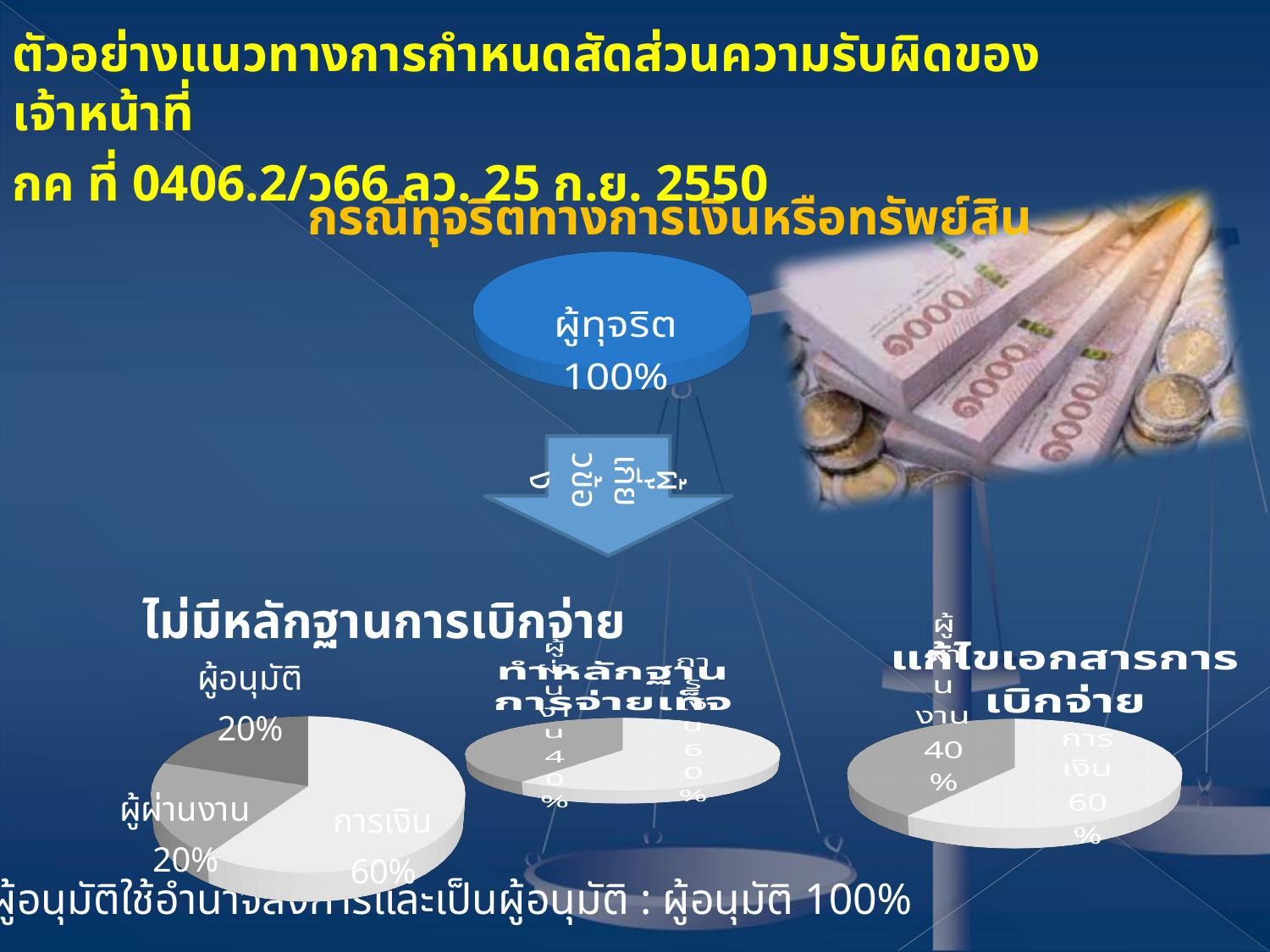
In the bottom-right pie chart (แก้ไขเอกสารการเบิกจ่าย), what is the value for ผู้ผ่านงาน? 40% In the bottom-right pie chart (แก้ไขเอกสารการเบิกจ่าย), what is the value for การเงิน? 60% What kind of chart is the chart under the heading ไม่มีหลักฐานการเบิกจ่าย (bottom left)? pie chart How many pie charts are shown along the bottom of the slide? 3 In the bottom-left pie chart (ไม่มีหลักฐานการเบิกจ่าย), what is the value for การเงิน? 60% How many slices does the bottom-right pie chart (แก้ไขเอกสารการเบิกจ่าย) have? 2 In the bottom-left pie chart (ไม่มีหลักฐานการเบิกจ่าย), which slice is the largest? การเงิน In the bottom-left pie chart (ไม่มีหลักฐานการเบิกจ่าย), what is the value for ผู้ผ่านงาน? 20% In the bottom-left pie chart (ไม่มีหลักฐานการเบิกจ่าย), what is the difference between the การเงิน slice and the ผู้อนุมัติ slice? 40% In the bottom-left pie chart (ไม่มีหลักฐานการเบิกจ่าย), which is larger, การเงิน or ผู้ผ่านงาน? การเงิน How many slices does the bottom-left pie chart (ไม่มีหลักฐานการเบิกจ่าย) have? 3 In the bottom-left pie chart (ไม่มีหลักฐานการเบิกจ่าย), what is the value for ผู้อนุมัติ? 20%